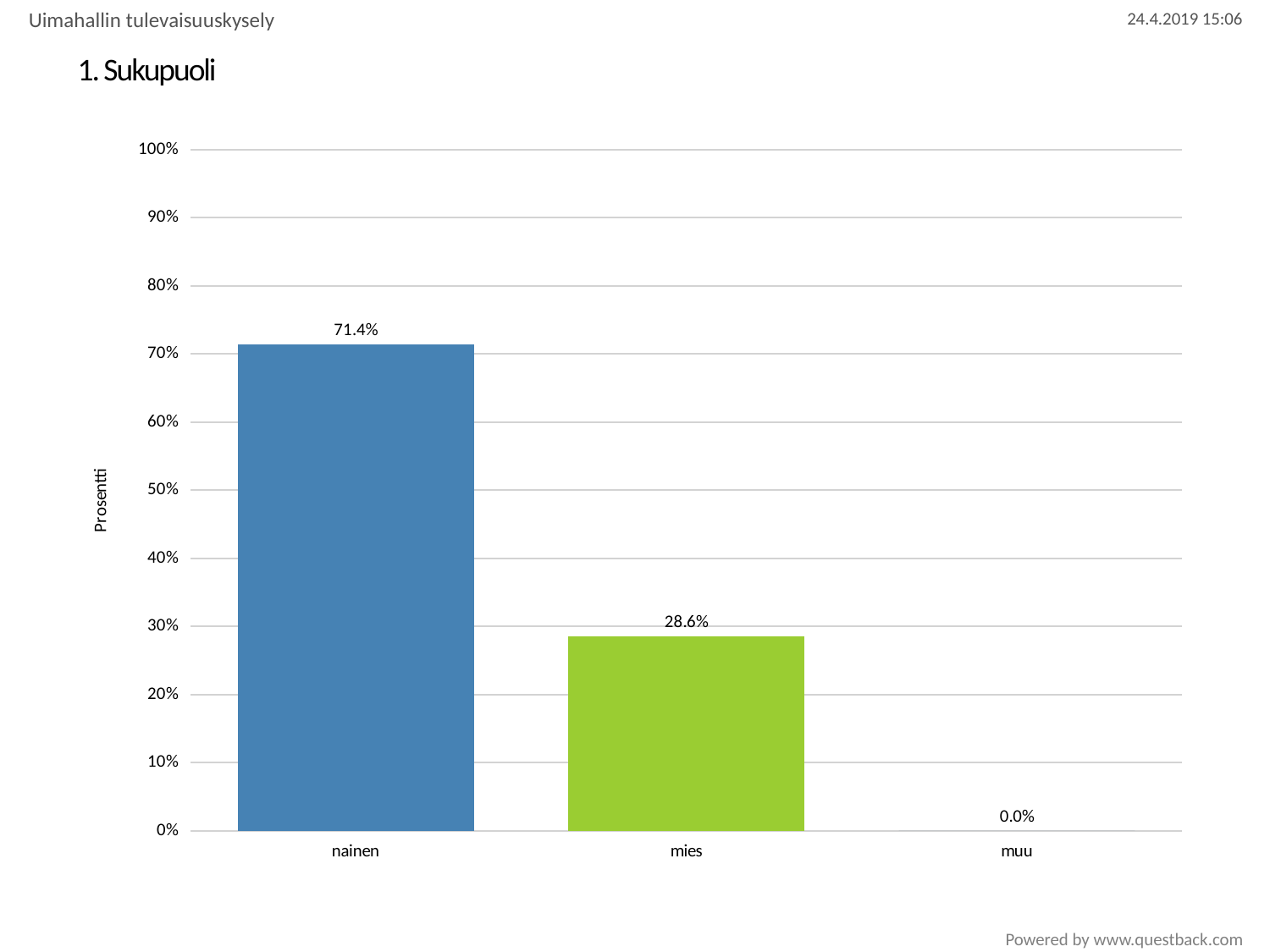
What is the title of the chart? 1. Sukupuoli What is the value for mies? 28.6% How many categories are shown on the x axis? 3 Is the value for mies greater or less than 30%? less What is the value for nainen? 71.4% What is the value for muu? 0.0% Which category has the highest value? nainen Is the value for nainen greater or less than 70%? greater Which category has the lowest value? muu Which is larger, the value for nainen or the value for mies? nainen What is the difference between the values for nainen and mies? 42.8% What kind of chart is shown on the slide? bar chart